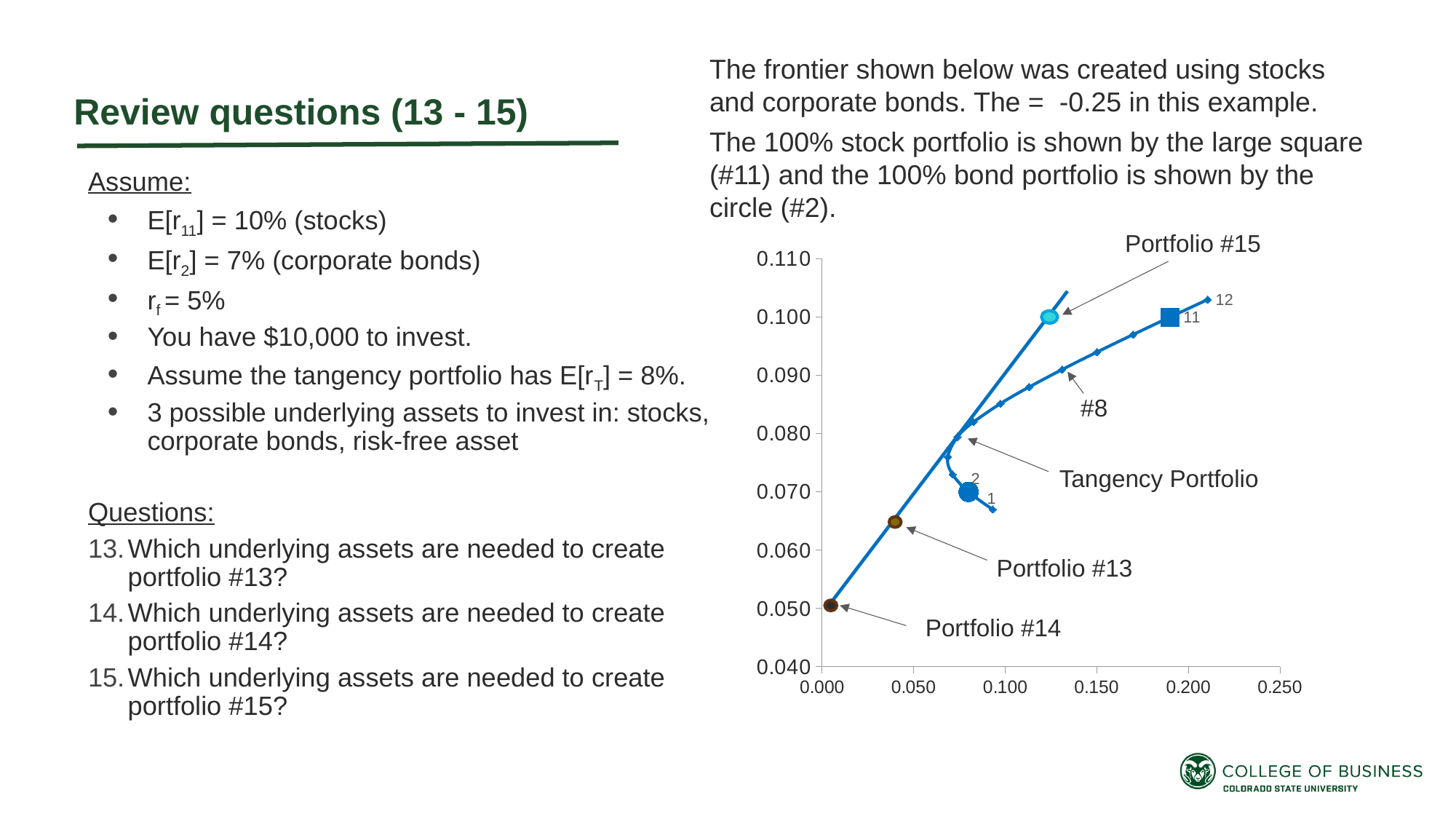
Which labeled point has the highest expected return on the chart? 12 What is the expected return (y-axis value) of the large square, portfolio #11? 0.100 Is the y-axis value for Portfolio #13 greater or less than 0.060? greater Which has the higher expected return, Portfolio #15 or Portfolio #13? Portfolio #15 What is the highest value shown on the y-axis? 0.110 What is the expected return (y-axis value) of Portfolio #14? 0.050 What kind of chart is shown on the slide? scatter chart Is the y-axis value for point #8 greater or less than 0.100? less What is the expected return (y-axis value) of the circle, portfolio #2? 0.070 What is the expected return (y-axis value) of Portfolio #15? 0.100 Is the x-axis value for point 12 greater or less than 0.200? greater Which labeled point has the lowest expected return on the chart? Portfolio #14